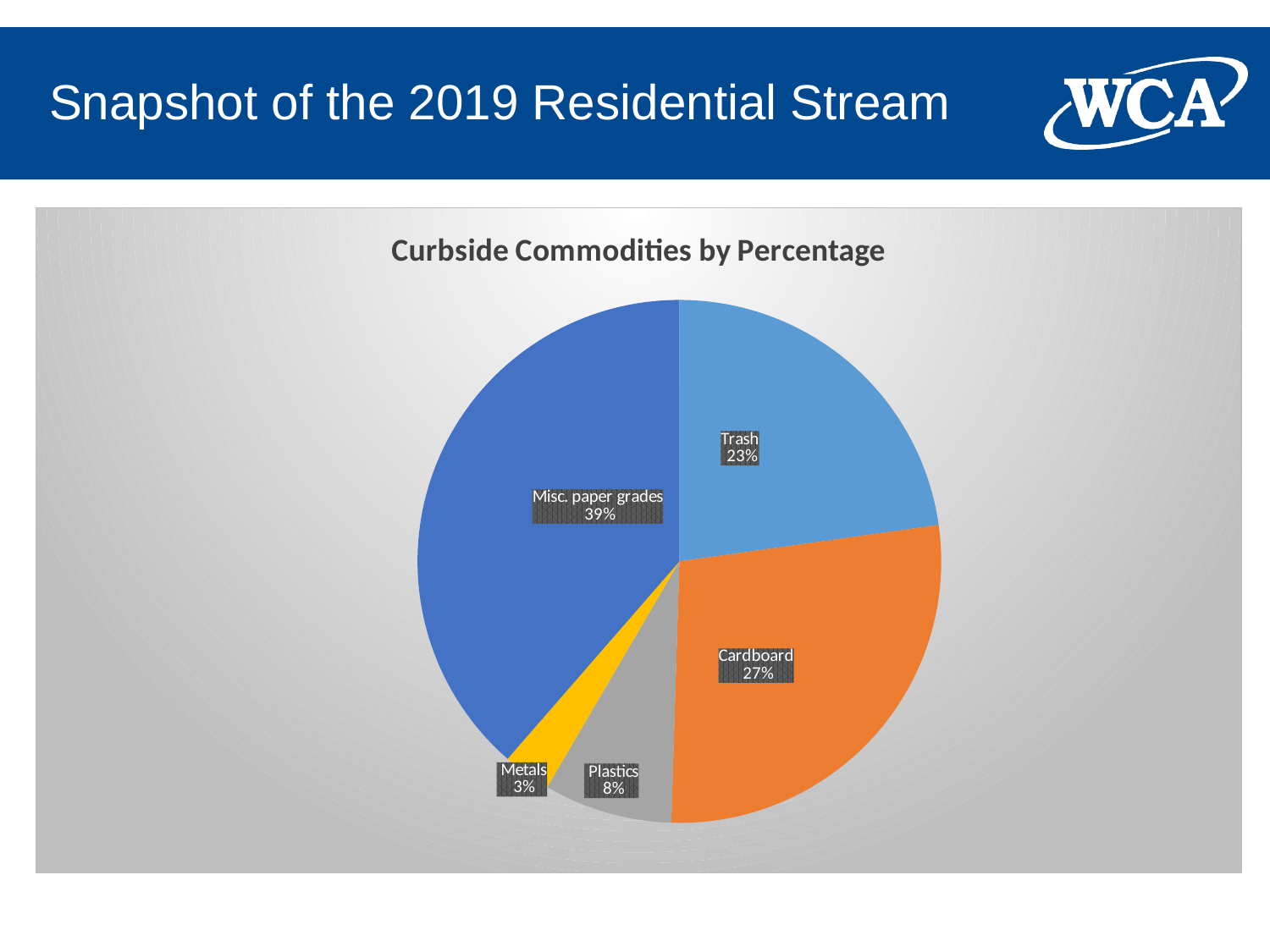
What percentage of the pie is Trash? 23% How many categories are shown in the pie chart? 5 Which category has the largest share of the pie? Misc. paper grades What type of chart is shown on the slide? pie chart What is the title of the chart? Curbside Commodities by Percentage What percentage of the pie is Misc. paper grades? 39% Which category has the smallest share of the pie? Metals Which is larger, the share for Plastics or the share for Metals? Plastics What percentage of the pie is Cardboard? 27% What is the difference in percentage points between Cardboard and Trash? 4 What percentage of the pie is Plastics? 8% What percentage of the pie is Metals? 3%